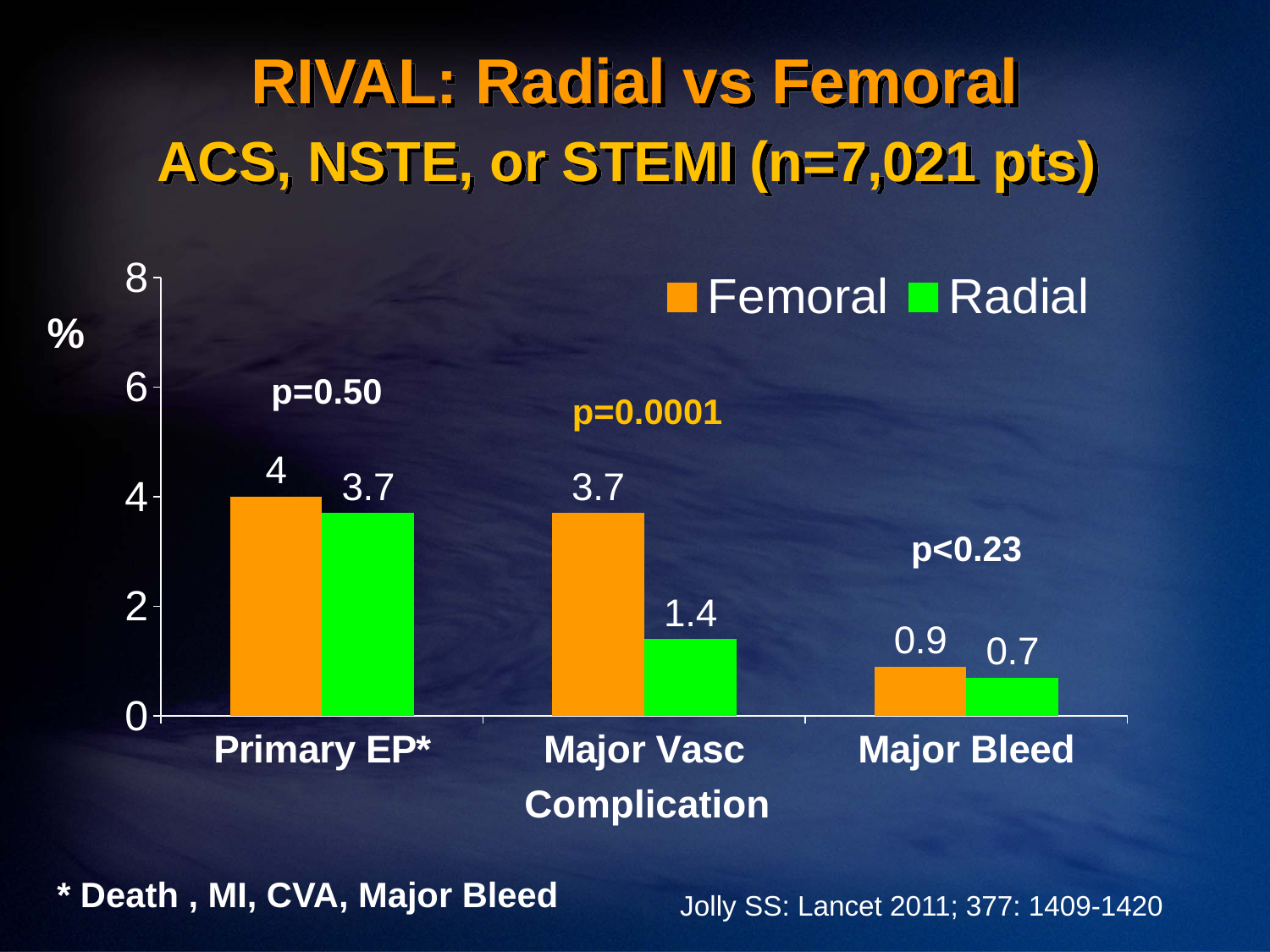
Which is larger for Major Vasc Complication, the Femoral value or the Radial value? Femoral Which category has the highest Femoral value? Primary EP* What kind of chart is shown on the slide? Bar chart How many series does the legend list? 2 Which category has the lowest Radial value? Major Bleed What is the Femoral value for Primary EP*? 4 How many categories are shown on the x axis? 3 What is the Radial value for Major Bleed? 0.7 What is the difference between the Femoral and Radial values for Major Vasc Complication? 2.3 What is the Radial value for Major Vasc Complication? 1.4 Which colour represents the Radial series in the legend? Green What is the Femoral value for Major Bleed? 0.9